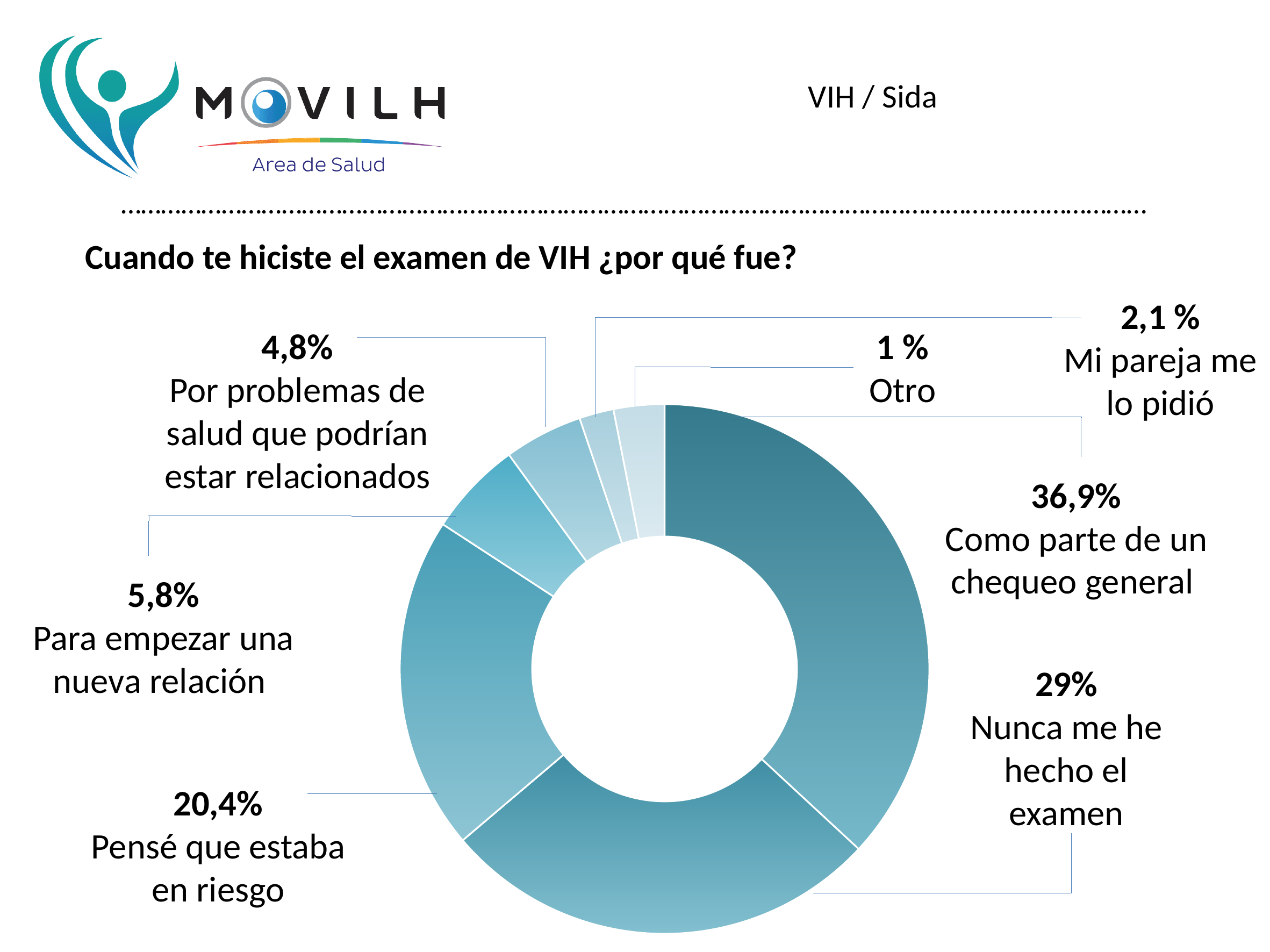
Which category has the largest share of the chart? Como parte de un chequeo general What share of respondents answered "Como parte de un chequeo general"? 36,9% What percentage is shown for "Pensé que estaba en riesgo"? 20,4% What question does the chart title ask? Cuando te hiciste el examen de VIH ¿por qué fue? What percentage is shown for "Mi pareja me lo pidió"? 2,1 % What is the difference between the shares for "Como parte de un chequeo general" and "Nunca me he hecho el examen"? 7,9% What kind of chart is shown on the slide? Doughnut (pie) chart How many categories are shown in the chart? 7 What percentage is shown for "Para empezar una nueva relación"? 5,8% What percentage is shown for "Nunca me he hecho el examen"? 29% Which is larger: the share for "Para empezar una nueva relación" or for "Por problemas de salud que podrían estar relacionados"? Para empezar una nueva relación Which category has the smallest share of the chart? Otro